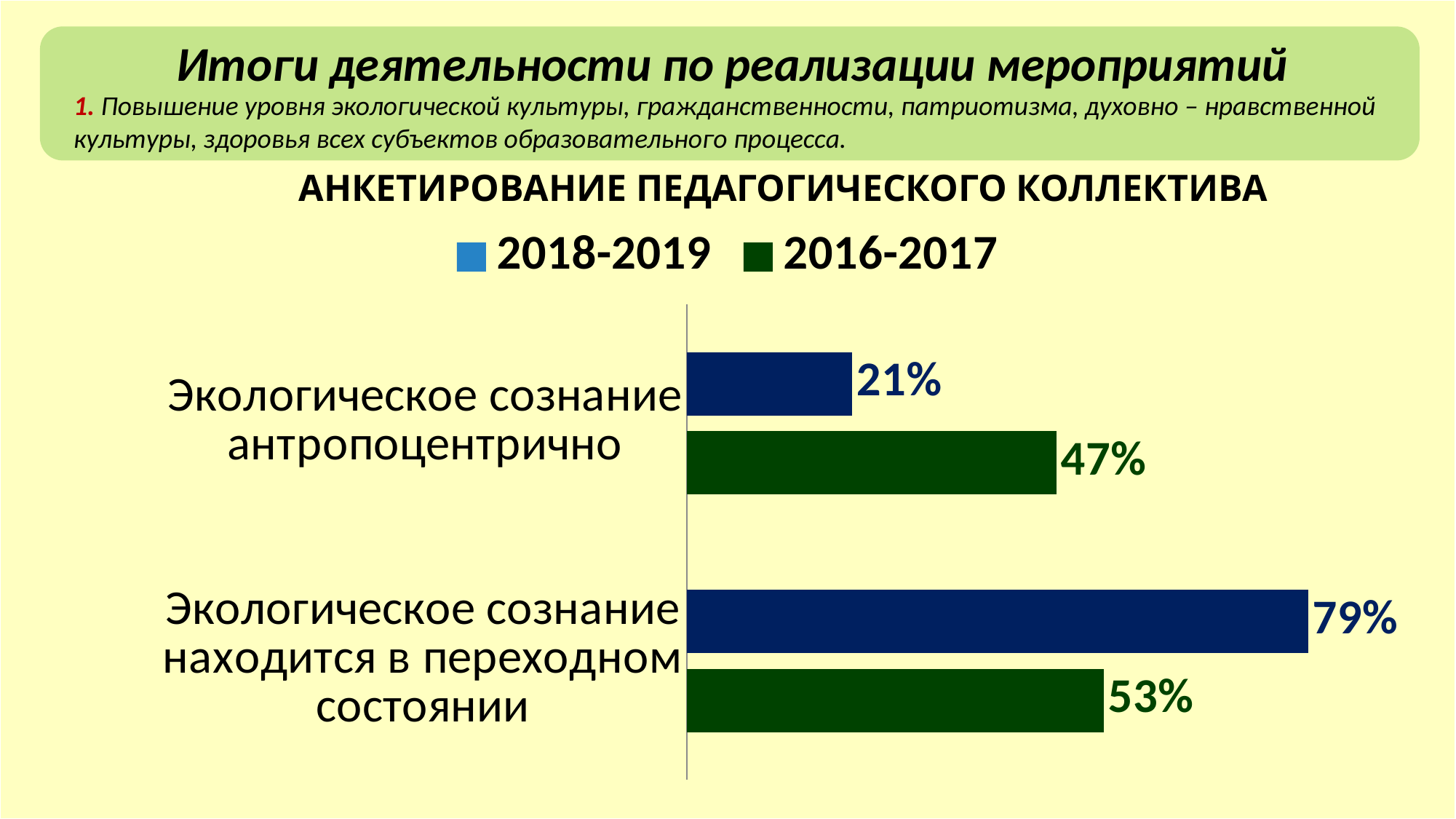
For "Экологическое сознание антропоцентрично", which series has the larger value, 2018-2019 or 2016-2017? 2016-2017 How many categories are shown in the chart? 2 Which category has the lowest value in the 2016-2017 series? Экологическое сознание антропоцентрично What is the difference between the 2018-2019 and 2016-2017 values for "Экологическое сознание находится в переходном состоянии"? 26% What is the 2016-2017 value for "Экологическое сознание находится в переходном состоянии"? 53% How many series does the legend list? 2 What is the 2018-2019 value for "Экологическое сознание находится в переходном состоянии"? 79% Which category has the highest value in the 2018-2019 series? Экологическое сознание находится в переходном состоянии What is the difference between the 2016-2017 and 2018-2019 values for "Экологическое сознание антропоцентрично"? 26% What is the 2018-2019 value for "Экологическое сознание антропоцентрично"? 21% What is the 2016-2017 value for "Экологическое сознание антропоцентрично"? 47% What kind of chart is shown on the slide? Bar chart